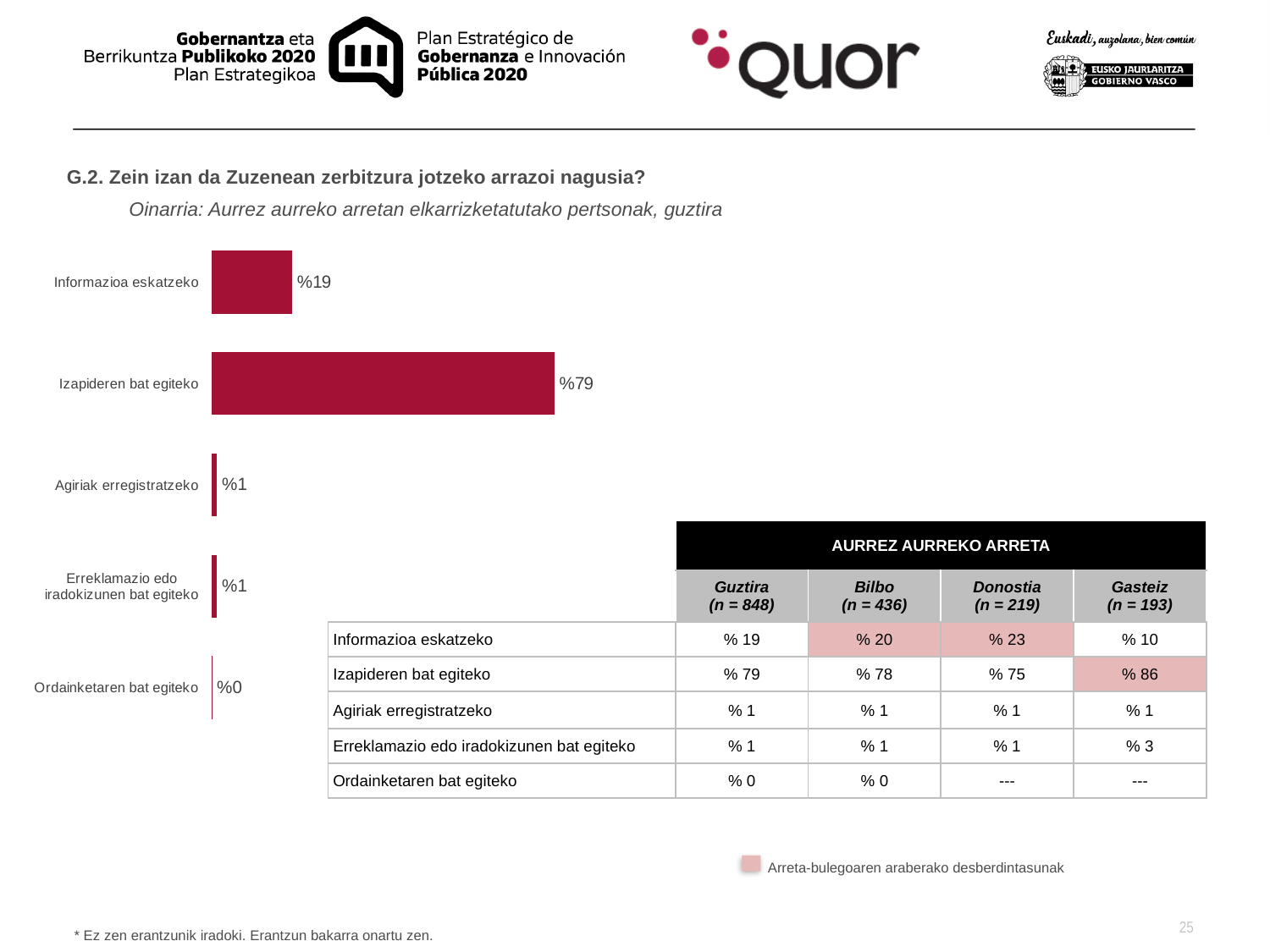
Which category has the highest value in the bar chart? Izapideren bat egiteko What is the value for "Informazioa eskatzeko" in the bar chart? %19 Which is larger in the bar chart: the value for "Informazioa eskatzeko" or the value for "Agiriak erregistratzeko"? Informazioa eskatzeko What is the value for "Ordainketaren bat egiteko" in the bar chart? %0 What is the value for "Agiriak erregistratzeko" in the bar chart? %1 What is the difference between the values for "Informazioa eskatzeko" and "Erreklamazio edo iradokizunen bat egiteko" in the bar chart? %18 What is the value for "Izapideren bat egiteko" in the bar chart? %79 Which category has the lowest value in the bar chart? Ordainketaren bat egiteko What colour are the bars in the bar chart? Dark red What kind of chart is shown on the slide? Bar chart What is the difference between the values for "Izapideren bat egiteko" and "Informazioa eskatzeko" in the bar chart? %60 How many categories are shown in the bar chart? 5